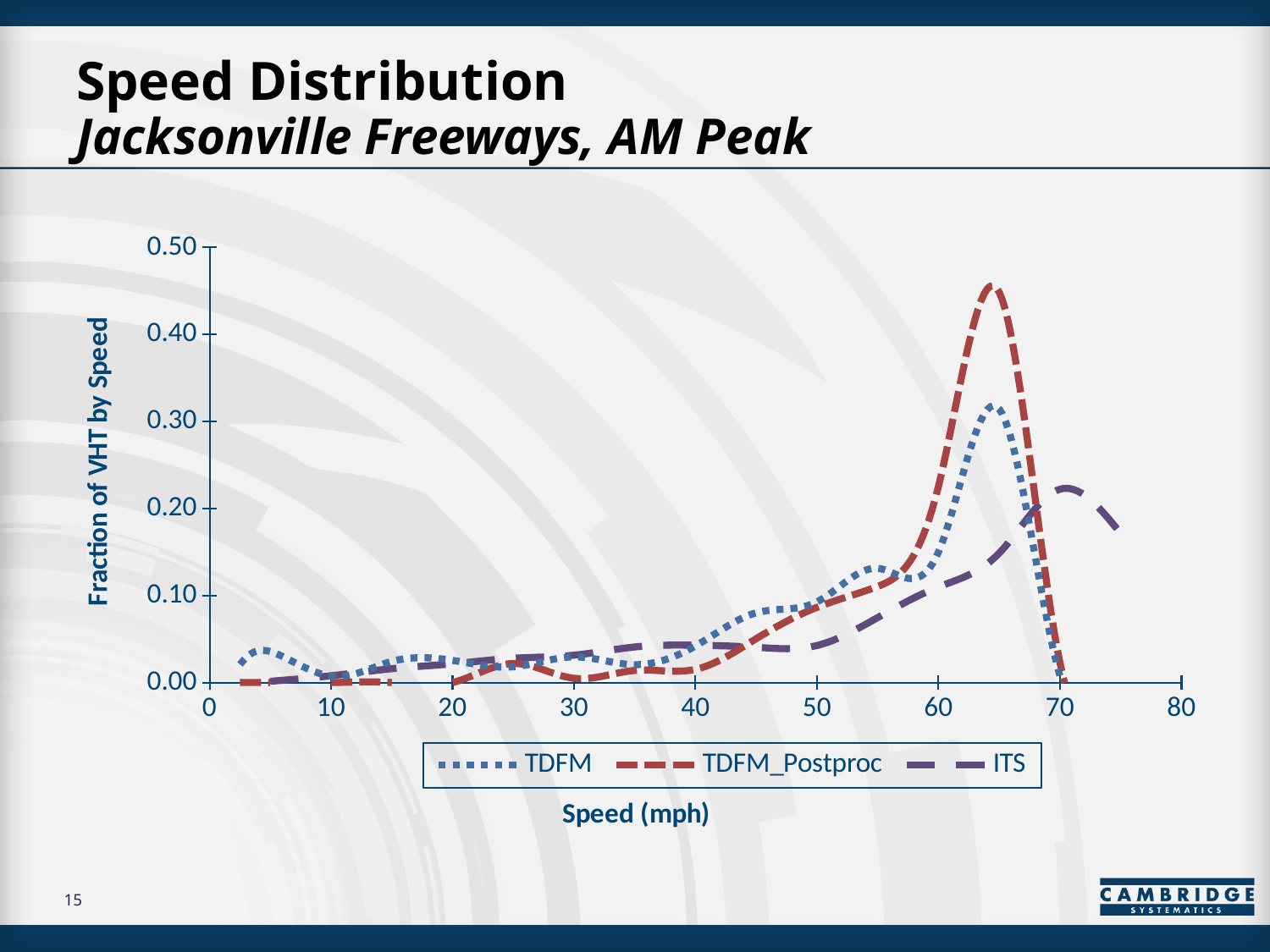
How many series does the legend list? 3 Which series has the lowest peak value on the chart? ITS Is the peak value of the TDFM_Postproc series greater or less than 0.40? greater Between 40 mph and 65 mph, do the values of the TDFM_Postproc series generally rise or fall? rise Is the peak value of the TDFM series greater or less than 0.30? greater What is the label of the vertical axis? Fraction of VHT by Speed Is the peak value of the ITS series greater or less than 0.20? greater What are the three series named in the legend? TDFM, TDFM_Postproc, ITS At a speed of about 65 mph, which series has the larger value, TDFM or TDFM_Postproc? TDFM_Postproc What kind of chart is shown on the slide? Line chart Which series reaches the highest peak value on the chart? TDFM_Postproc